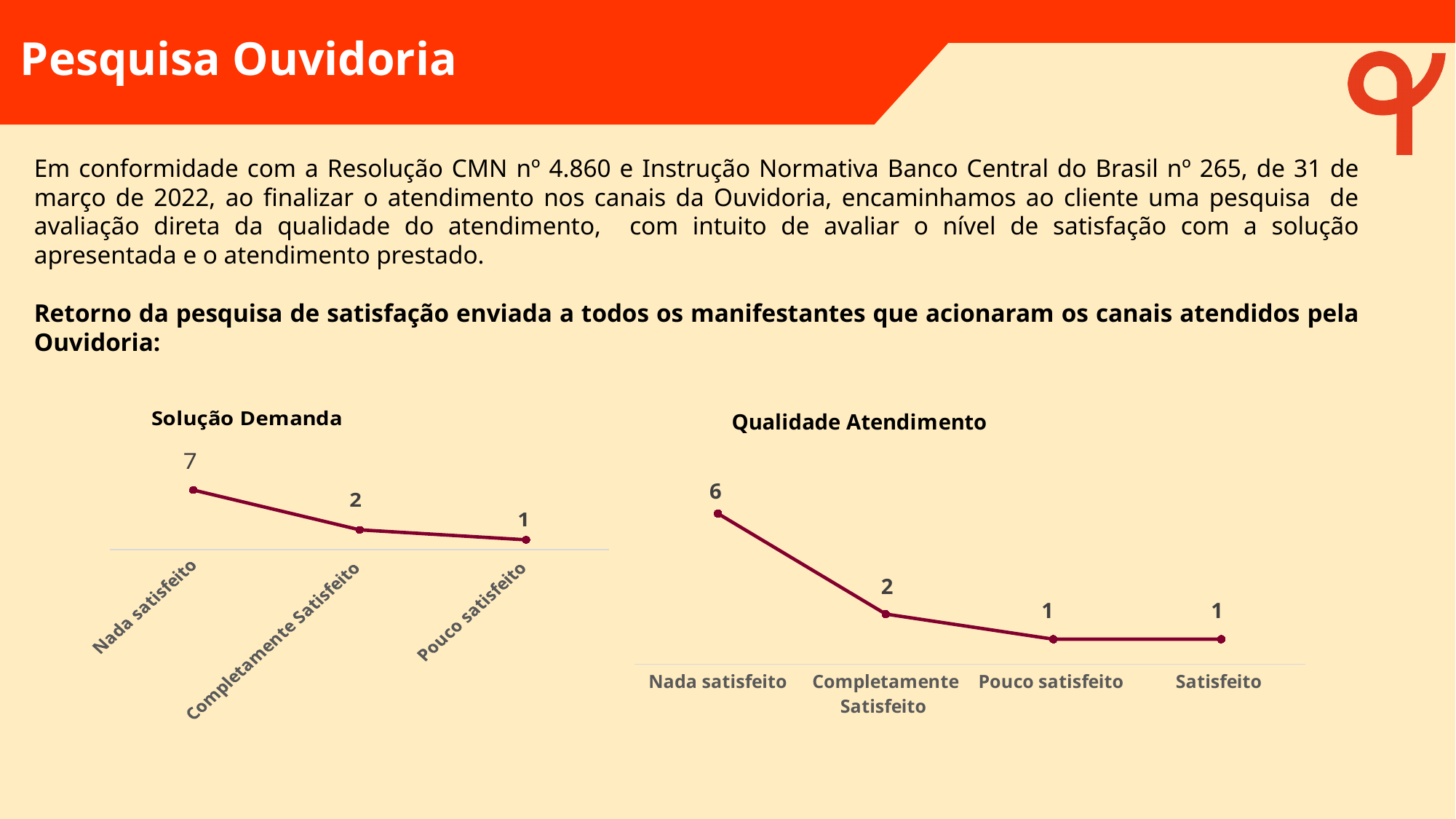
In the 'Qualidade Atendimento' chart, which category has the highest value? Nada satisfeito In the 'Solução Demanda' chart, which category has the highest value? Nada satisfeito In the 'Solução Demanda' chart, which category has the lowest value? Pouco satisfeito In the 'Solução Demanda' chart, what is the value for Completamente Satisfeito? 2 What kind of chart is the 'Qualidade Atendimento' chart? Line chart In the 'Solução Demanda' chart, what is the value for Nada satisfeito? 7 In the 'Solução Demanda' chart, how many categories are plotted? 3 In the 'Qualidade Atendimento' chart, what is the difference between Nada satisfeito and Completamente Satisfeito? 4 In the 'Qualidade Atendimento' chart, how many categories are plotted? 4 In the 'Qualidade Atendimento' chart, what is the value for Nada satisfeito? 6 In the 'Qualidade Atendimento' chart, what is the value for Satisfeito? 1 In the 'Solução Demanda' chart, what is the difference between Nada satisfeito and Completamente Satisfeito? 5